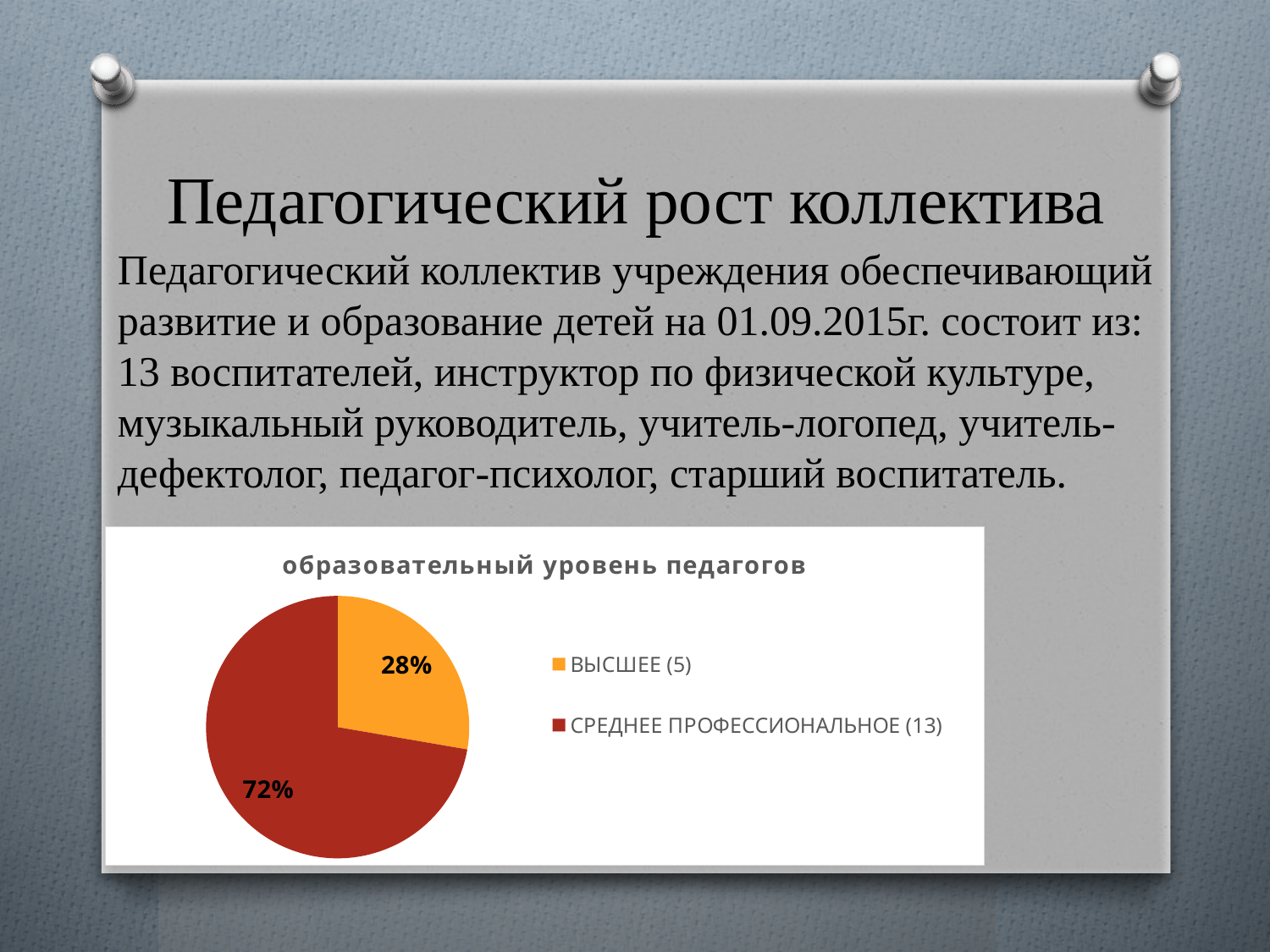
Is the share for ВЫСШЕЕ (5) greater or less than 50%? less How many categories does the pie chart show? 2 Which category has the largest slice of the pie? СРЕДНЕЕ ПРОФЕССИОНАЛЬНОЕ (13) What share of the pie does ВЫСШЕЕ (5) take? 28% What kind of chart is shown on the slide? pie chart What is the title of the chart? образовательный уровень педагогов Which slice is larger, ВЫСШЕЕ (5) or СРЕДНЕЕ ПРОФЕССИОНАЛЬНОЕ (13)? СРЕДНЕЕ ПРОФЕССИОНАЛЬНОЕ (13) Which category has the smallest slice of the pie? ВЫСШЕЕ (5) What colour is the ВЫСШЕЕ (5) slice in the pie chart? orange What share of the pie does СРЕДНЕЕ ПРОФЕССИОНАЛЬНОЕ (13) take? 72% What is the difference in percentage points between the СРЕДНЕЕ ПРОФЕССИОНАЛЬНОЕ (13) slice and the ВЫСШЕЕ (5) slice? 44%